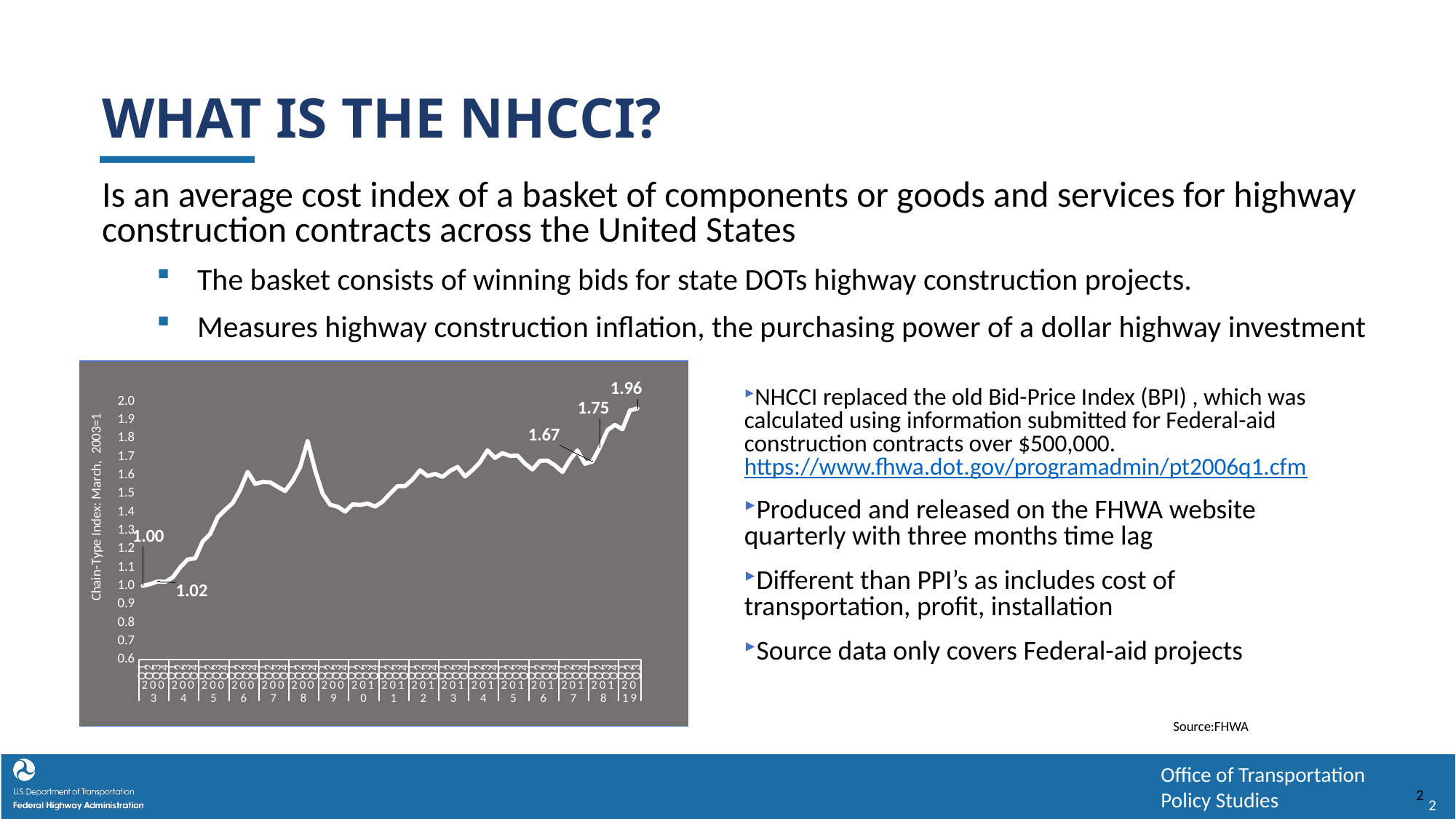
Which labeled value is larger, 1.75 or 1.67? 1.75 What is the difference between the labeled values 1.96 and 1.75? 0.21 What is the difference between the labeled values 1.96 and 1.00? 0.96 What is the data label at the end of the line in 2019? 1.96 Overall, does the index rise or fall from 2003 to 2019? rise What is the data label at the start of the line in 2003? 1.00 What is the highest data label shown on the chart? 1.96 What is the data label shown just before 1.75 on the line? 1.67 What kind of chart is shown on the slide? line chart What is the label on the vertical axis of the chart? Chain-Type Index: March, 2003=1 Is the peak value of the line in 2008 greater or less than 1.7? greater What is the lowest data label shown on the chart? 1.00